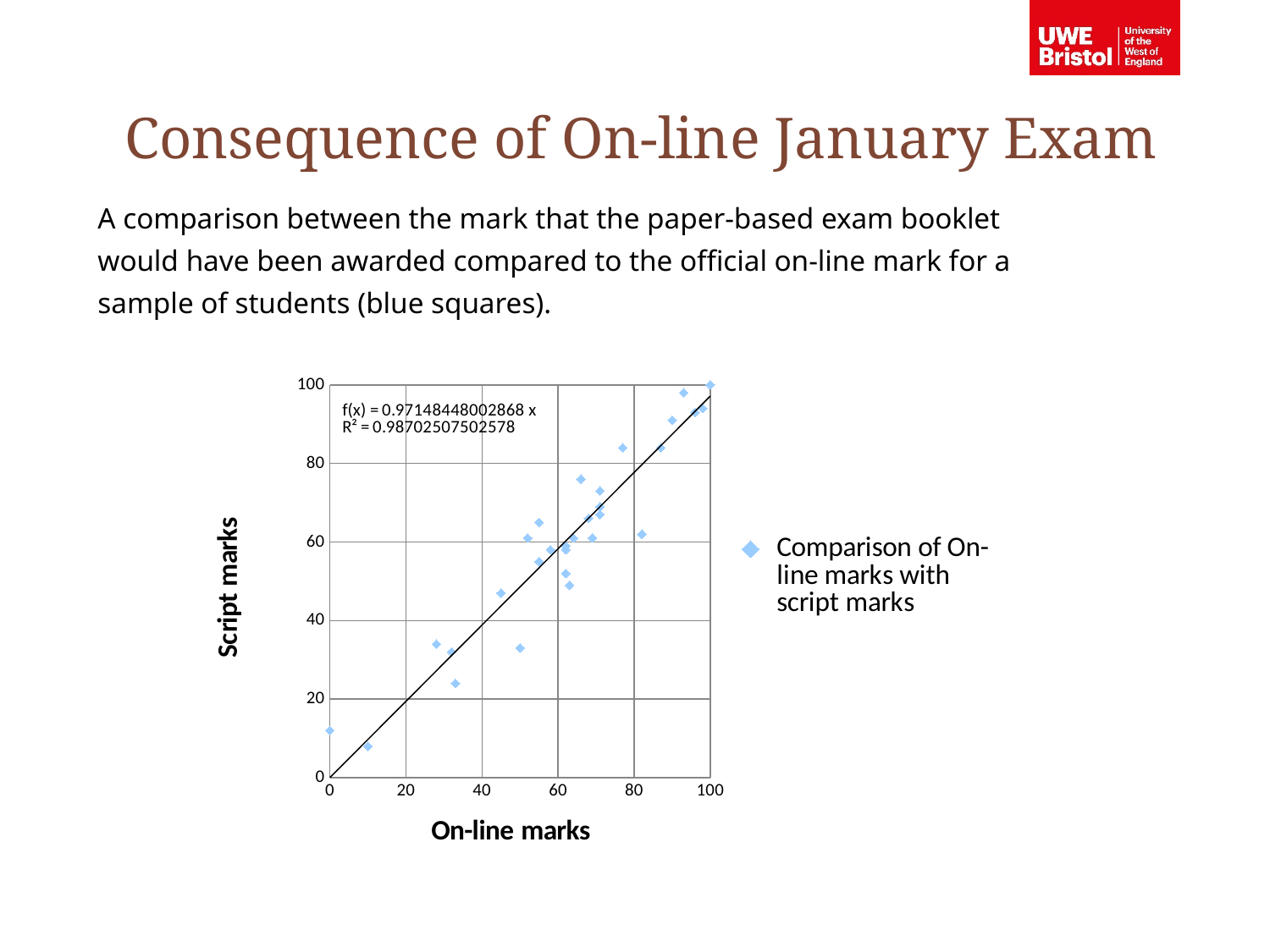
How many series does the chart legend list? 1 What is the title of the vertical axis? Script marks What R² value is printed on the chart for the trendline? 0.98702507502578 What is the highest value shown on the x axis? 100 What is the legend entry for the plotted series? Comparison of On-line marks with script marks What is the slope coefficient in the trendline equation printed on the chart? 0.97148448002868 Is the script mark for the student with an on-line mark of 0 greater or less than 20? less Do the script marks generally rise or fall as the on-line marks increase along the x axis? rise Is the script mark for the student with an on-line mark of 100 greater or less than 80? greater What kind of chart is shown on the slide? scatter chart